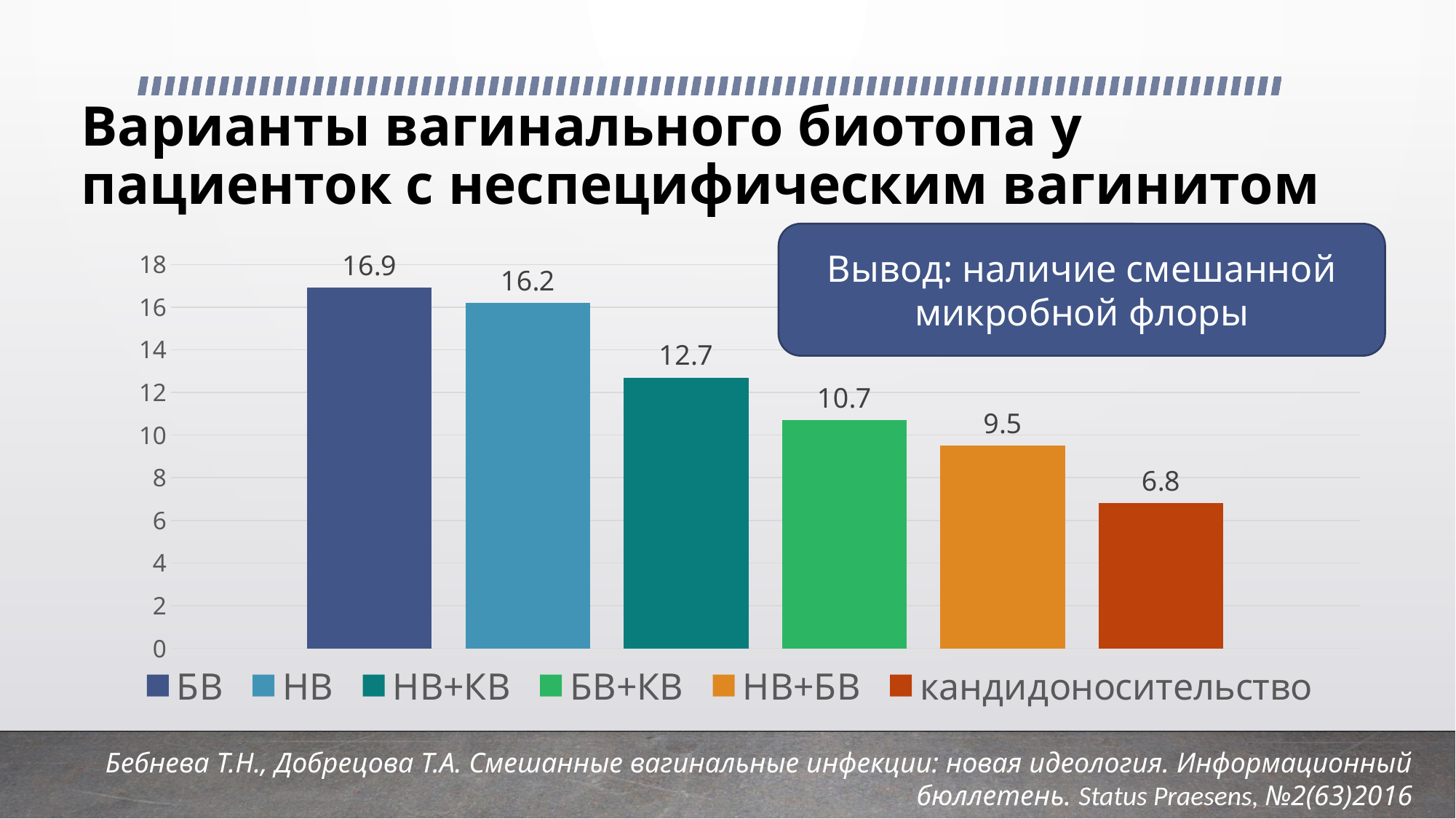
How many entries does the legend list? 6 What is the value for БВ? 16.9 Which category has the lowest value? кандидоносительство Which is larger, the value for НВ+КВ or the value for НВ+БВ? НВ+КВ What is the difference between the values for БВ and НВ? 0.7 How many categories are shown in the chart? 6 What is the difference between the values for БВ+КВ and НВ+БВ? 1.2 What kind of chart is shown on the slide? bar chart Do the values rise or fall from left to right across the bars? fall What is the value for НВ+КВ? 12.7 Which category has the highest value? БВ What is the value for кандидоносительство? 6.8